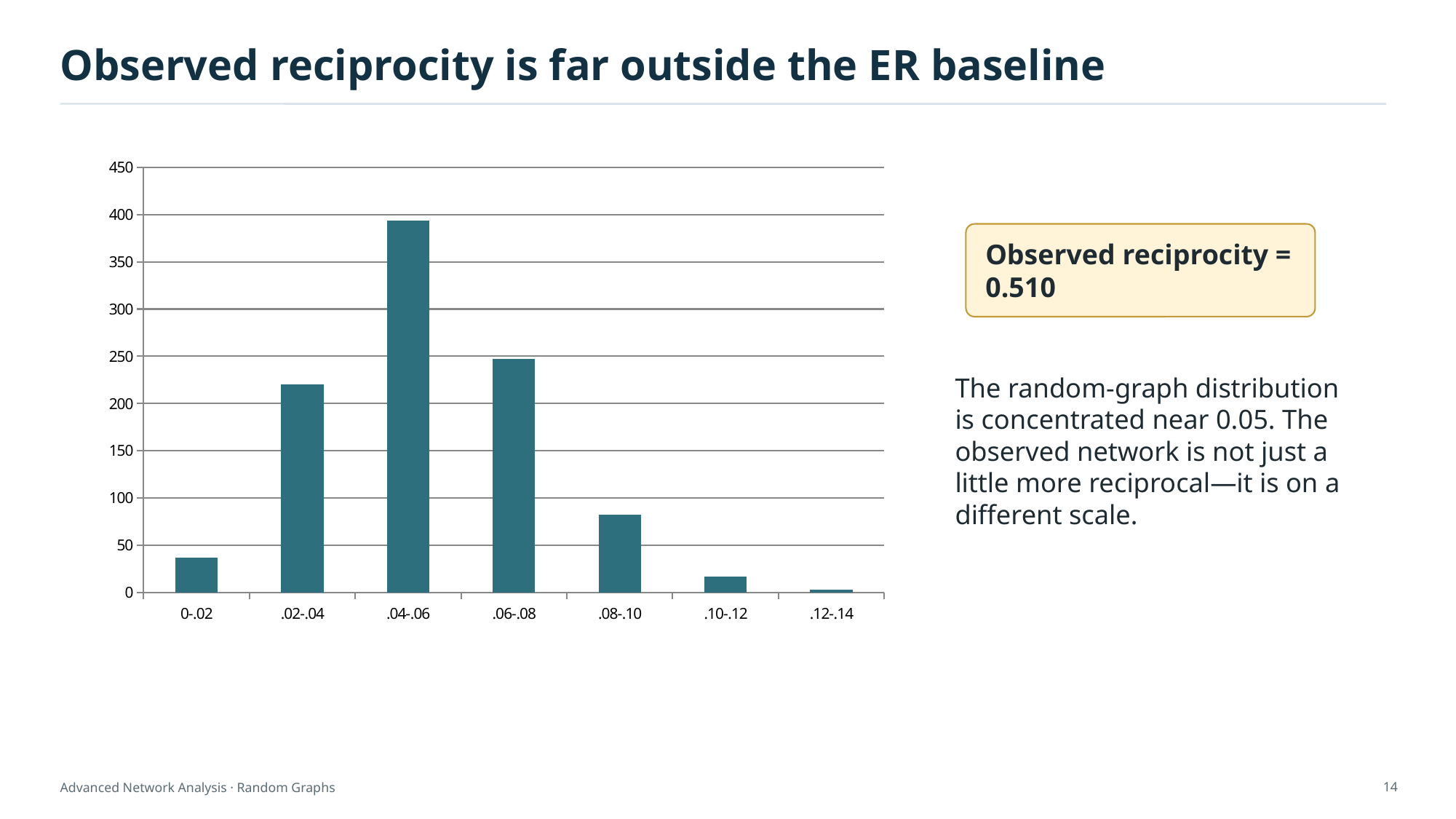
Which bin has the larger value, 0-.02 or .10-.12? 0-.02 Is the value for the .08-.10 bin greater or less than 100? less Which bin has the lowest bar in the chart? .12-.14 How many bins (categories) are shown on the x axis of the chart? 7 Is the value for the 0-.02 bin greater or less than 50? less Which bin has the larger value, .02-.04 or .06-.08? .06-.08 Is the value for the .06-.08 bin greater or less than 200? greater What is the maximum value shown on the y axis of the chart? 450 What kind of chart is shown on the slide? bar chart Which bin has the highest bar in the chart? .04-.06